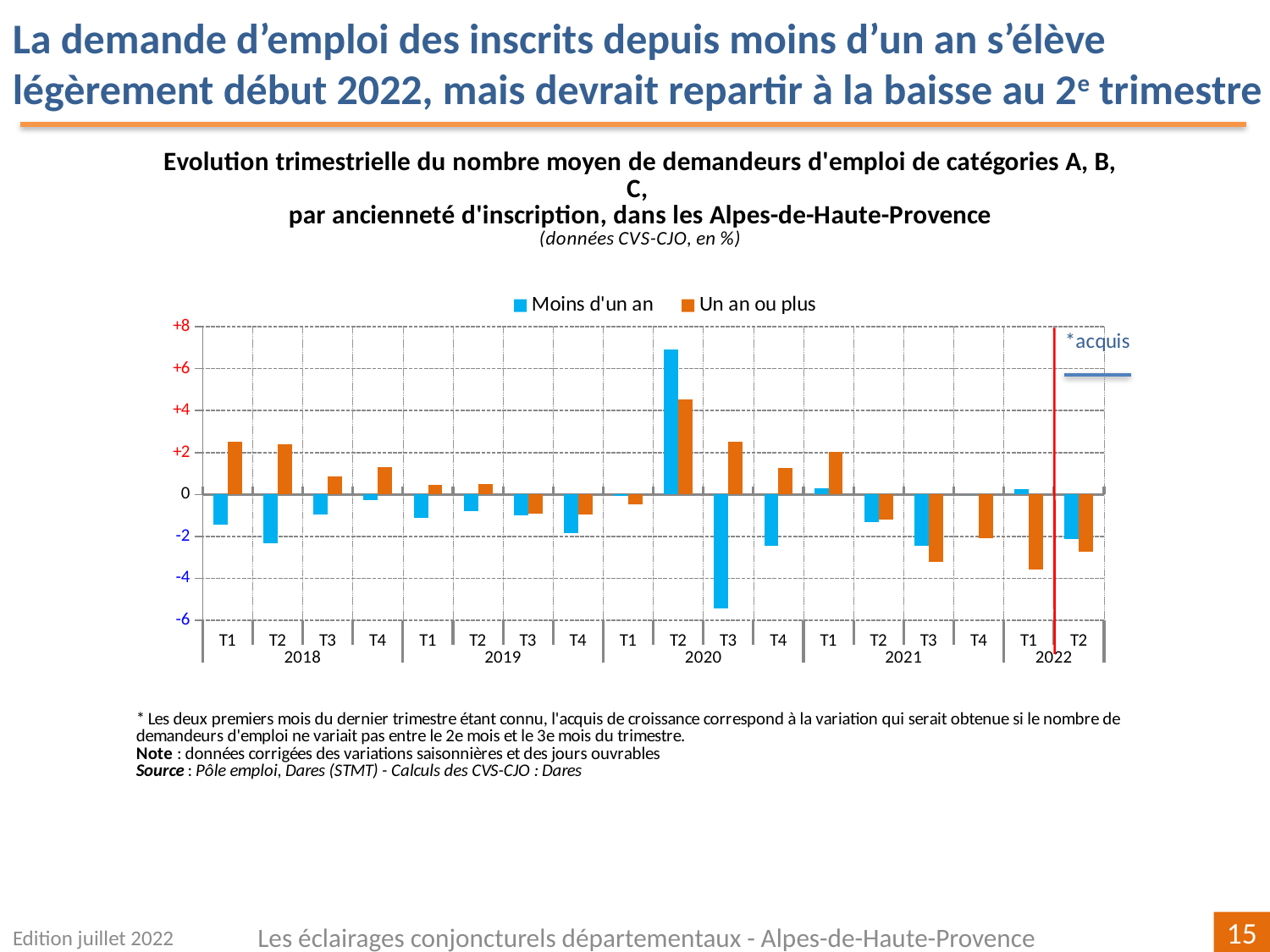
How many quarters are plotted along the x axis? 18 What kind of chart is shown on the slide? bar chart How many series does the legend list? 2 Is the value for 'Un an ou plus' in T1 2022 greater or less than -2? less In which quarter is the value for 'Un an ou plus' the lowest? T1 2022 Which colour represents the series 'Un an ou plus' in the legend? orange In which quarter is the value for 'Moins d'un an' the highest? T2 2020 In which quarter is the value for 'Moins d'un an' the lowest? T3 2020 In which quarter is the value for 'Un an ou plus' the highest? T2 2020 Is the value for 'Moins d'un an' in T2 2020 greater or less than +6? greater In T3 2020, which series has the larger value, 'Moins d'un an' or 'Un an ou plus'? Un an ou plus In T2 2020, which series has the larger value, 'Moins d'un an' or 'Un an ou plus'? Moins d'un an